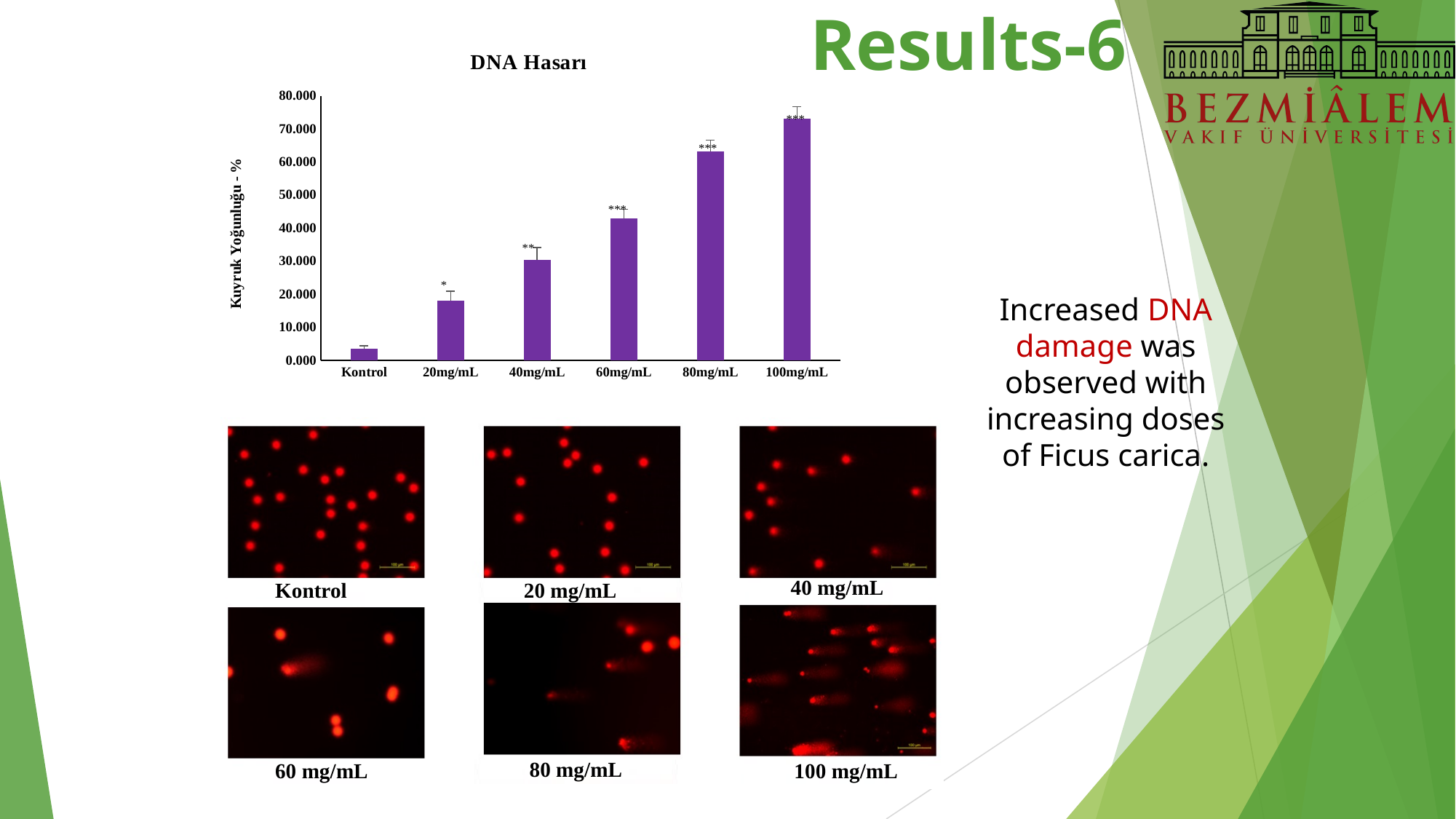
Is the value for 100mg/mL greater or less than 70.000? greater What is the title of the chart? DNA Hasarı Which is larger, the value for 80mg/mL or the value for 40mg/mL? 80mg/mL Which category has the lowest bar in the chart? Kontrol What type of chart is shown on the slide? bar chart Is the value for 40mg/mL greater or less than 20.000? greater Which category has the highest bar in the chart? 100mg/mL How many categories are plotted on the x axis of the chart? 6 What is the label of the y axis of the chart? Kuyruk Yoğunluğu - % Is the value for 80mg/mL greater or less than 50.000? greater Do the values rise or fall from Kontrol to 100mg/mL along the x axis? rise